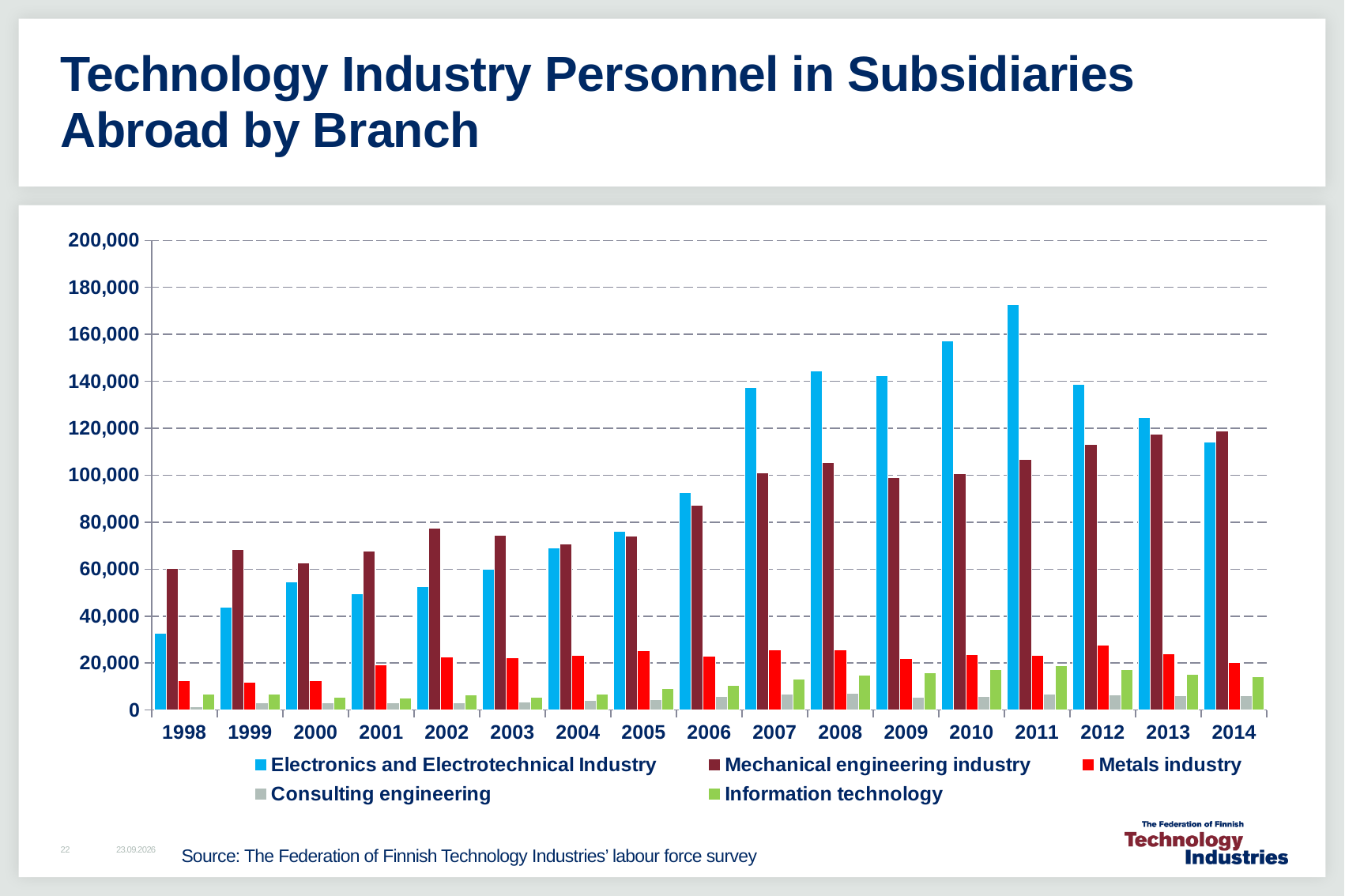
How many years are shown on the x axis? 17 Is the value for Electronics and Electrotechnical Industry in 2011 greater or less than 160,000? greater How many series does the legend list? 5 In which year is the Electronics and Electrotechnical Industry value highest? 2011 Is the value for Mechanical engineering industry in 1998 greater or less than 80,000? less Is the value for Electronics and Electrotechnical Industry in 1998 greater or less than 40,000? less In 1998, which is larger: Electronics and Electrotechnical Industry or Mechanical engineering industry? Mechanical engineering industry In which year is the Electronics and Electrotechnical Industry value lowest? 1998 What kind of chart is shown on the slide? bar chart In 2011, which is larger: Electronics and Electrotechnical Industry or Mechanical engineering industry? Electronics and Electrotechnical Industry Does the Electronics and Electrotechnical Industry value rise or fall from 2011 to 2014? fall